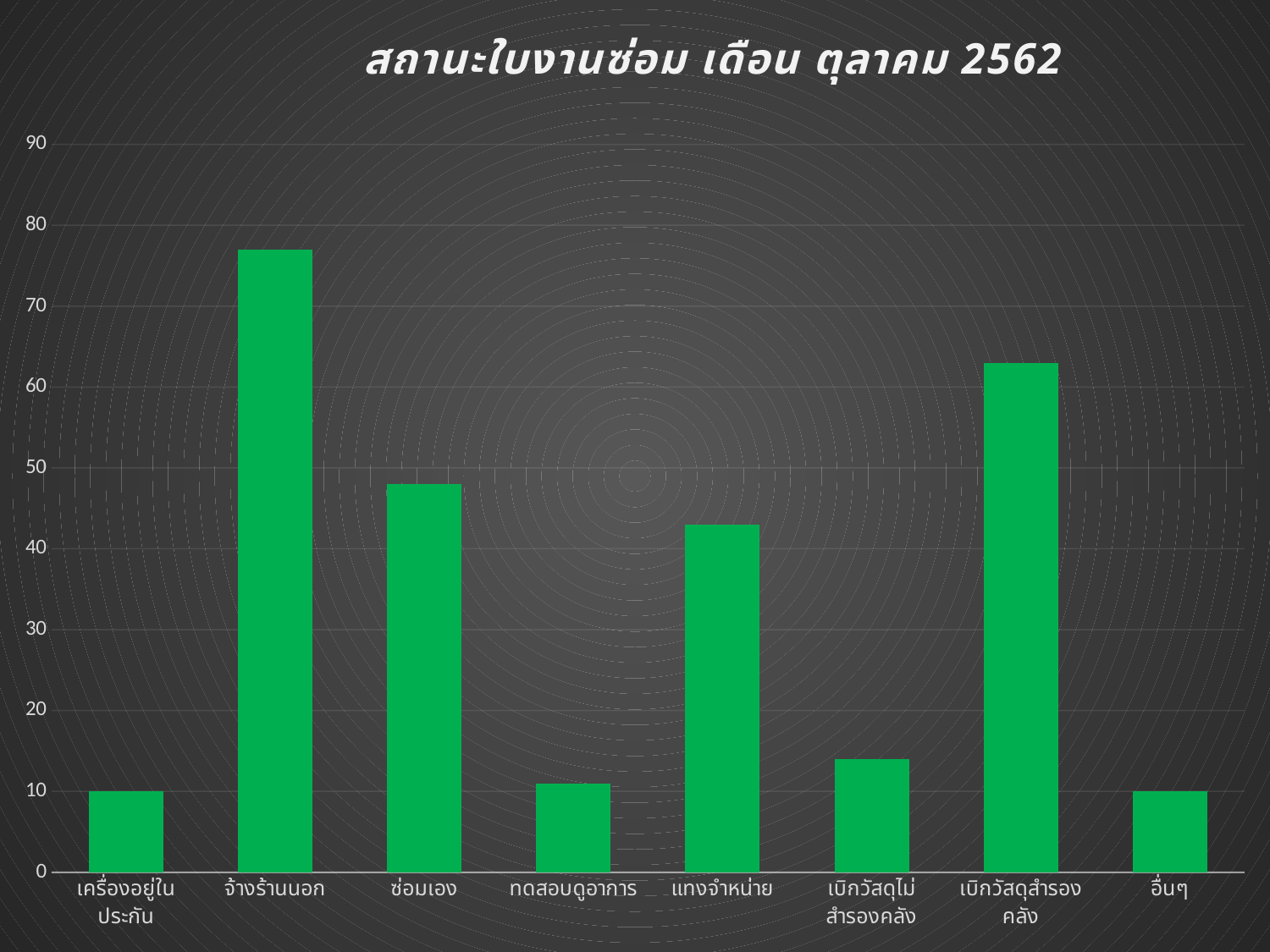
Is the value for ซ่อมเอง greater or less than 50? less What is the value for อื่นๆ? 10 What is the value for เครื่องอยู่ในประกัน? 10 What type of chart is shown on the slide? bar chart Which is larger, the value for ซ่อมเอง or the value for เบิกวัสดุสำรองคลัง? เบิกวัสดุสำรองคลัง Which is larger, the value for ทดสอบดูอาการ or the value for เบิกวัสดุไม่สำรองคลัง? เบิกวัสดุไม่สำรองคลัง Which category has the highest value in the chart? จ้างร้านนอก Is the value for จ้างร้านนอก greater or less than 70? greater Is the value for แทงจำหน่าย greater or less than 40? greater What is the title of the chart? สถานะใบงานซ่อม เดือน ตุลาคม 2562 How many categories are shown on the x axis of the chart? 8